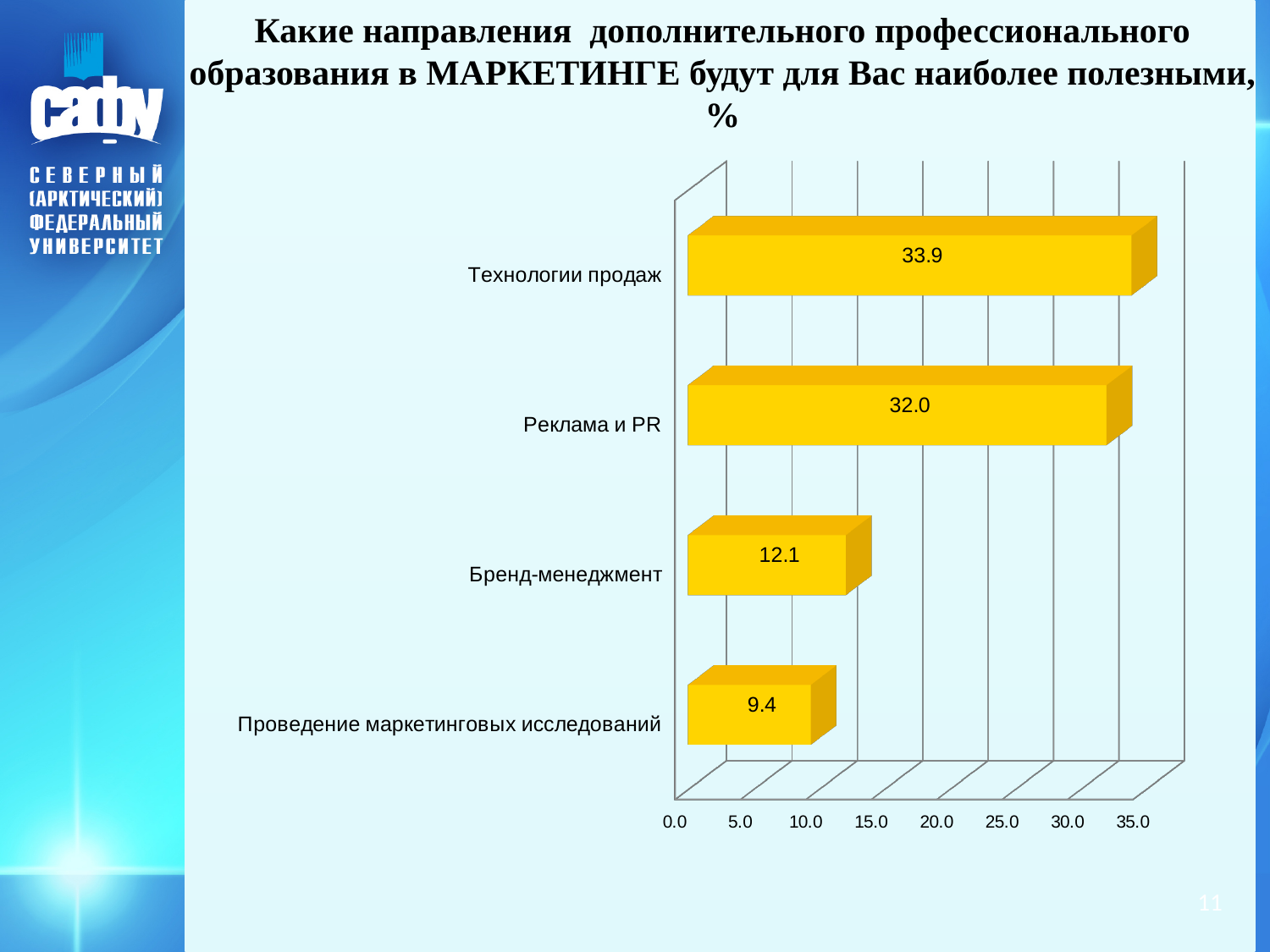
What kind of chart is shown on the slide? bar chart Which category has the highest value? Технологии продаж What is the difference between the values for Бренд-менеджмент and Проведение маркетинговых исследований? 2.7 What is the value for Проведение маркетинговых исследований? 9.4 How many categories are shown in the chart? 4 What is the value for Бренд-менеджмент? 12.1 Is the value for Бренд-менеджмент greater or less than 10.0? greater Which category has the lowest value? Проведение маркетинговых исследований What is the difference between the values for Технологии продаж and Реклама и PR? 1.9 What is the value for Реклама и PR? 32.0 What is the value for Технологии продаж? 33.9 Which is larger, the value for Реклама и PR or the value for Бренд-менеджмент? Реклама и PR